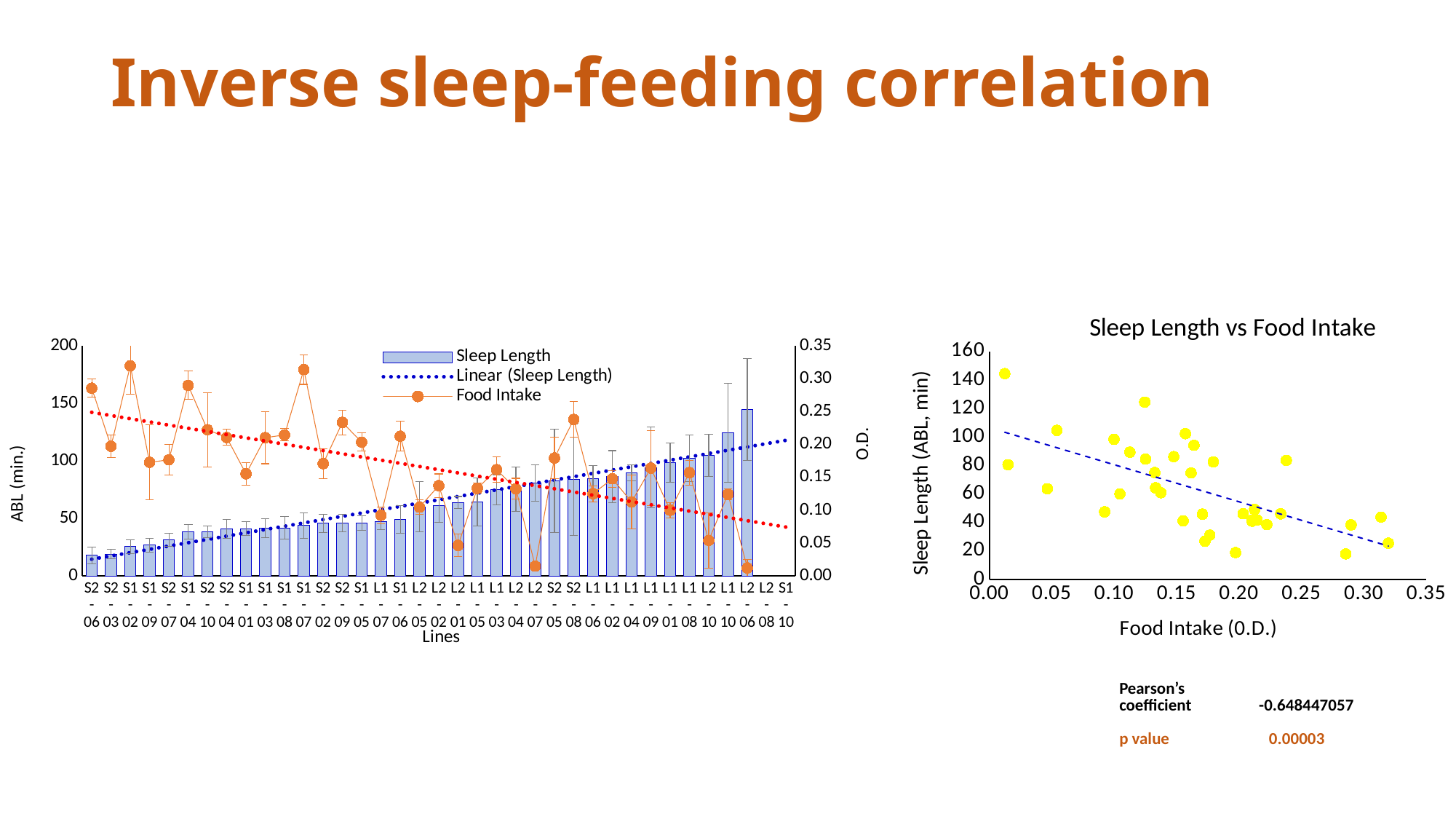
What kind of chart is the right chart, titled 'Sleep Length vs Food Intake'? Scatter chart In the left chart, do the Sleep Length bars rise or fall from left to right along the x axis? Rise What is the title of the right chart? Sleep Length vs Food Intake What Pearson's coefficient is reported below the right chart? -0.648447057 In the left chart, which line has the highest Sleep Length? L2-06 In the left chart, is the Sleep Length value for line L2-06 greater or less than 100? greater In the left chart, is the Food Intake value for line S2-06 greater or less than 0.25? greater How many series does the legend of the left chart list? 3 In the right chart, does Sleep Length rise or fall as Food Intake increases? Fall In the left chart, which is larger: the Sleep Length for L2-06 or for S2-06? L2-06 In the left chart, is the Sleep Length value for line S2-06 greater or less than 50? less What kind of chart is the left chart? A bar chart with a line series (combo chart)